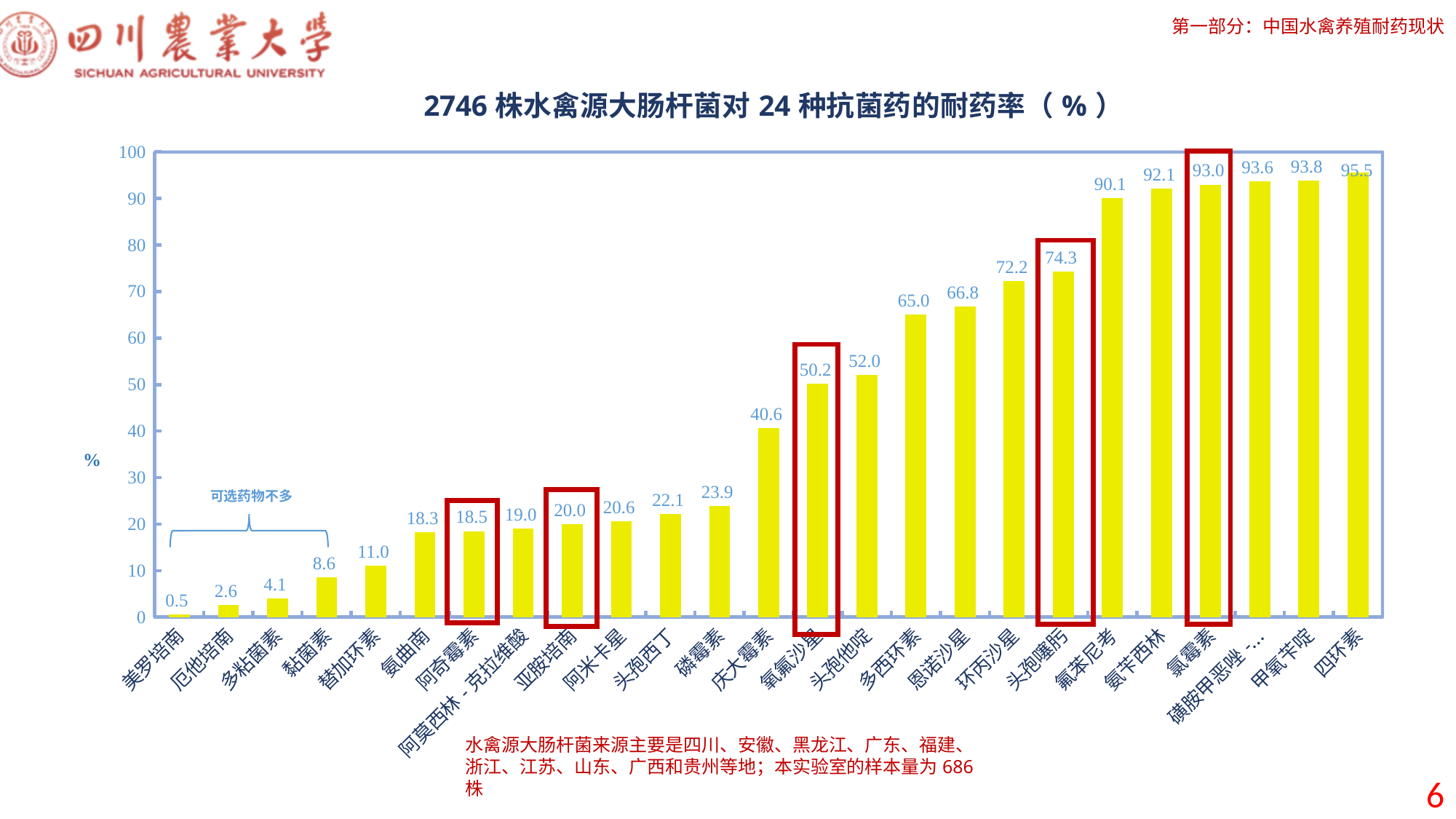
What is the resistance rate for 四环素? 95.5 Do the resistance rates rise or fall from left to right along the x axis? rise What is the difference between the resistance rates of 氯霉素 and 阿奇霉素? 74.5 Which antibiotic has the highest resistance rate? 四环素 Is the resistance rate for 环丙沙星 greater or less than 70? greater What is the difference between the resistance rates of 头孢他啶 and 庆大霉素? 11.4 What is the resistance rate for 亚胺培南? 20.0 Which has a higher resistance rate, 恩诺沙星 or 多西环素? 恩诺沙星 Which antibiotic has the lowest resistance rate? 美罗培南 What is the resistance rate for 头孢噻肟? 74.3 What is the resistance rate for 氧氟沙星? 50.2 What type of chart is shown on the slide? bar chart